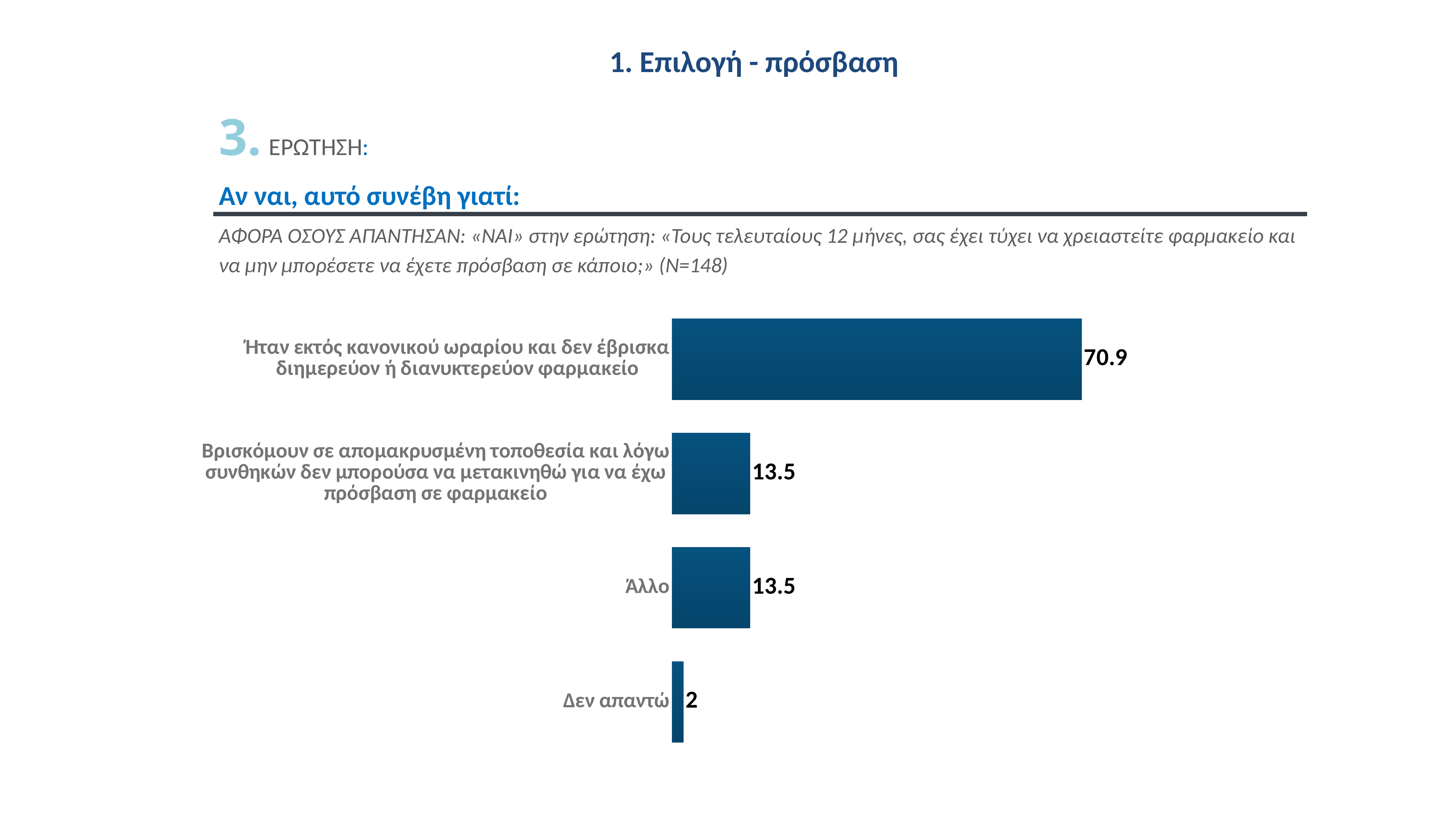
What is the value for 'Ήταν εκτός κανονικού ωραρίου και δεν έβρισκα διημερεύον ή διανυκτερεύον φαρμακείο'? 70.9 How many categories are shown in the chart? 4 Which is larger: the value for 'Άλλο' or the value for 'Δεν απαντώ'? Άλλο What is the value for 'Άλλο'? 13.5 What is the value for 'Δεν απαντώ'? 2 Which category has the highest value? Ήταν εκτός κανονικού ωραρίου και δεν έβρισκα διημερεύον ή διανυκτερεύον φαρμακείο What is the value for 'Βρισκόμουν σε απομακρυσμένη τοποθεσία και λόγω συνθηκών δεν μπορούσα να μετακινηθώ για να έχω πρόσβαση σε φαρμακείο'? 13.5 What is the difference between the value for 'Ήταν εκτός κανονικού ωραρίου και δεν έβρισκα διημερεύον ή διανυκτερεύον φαρμακείο' and the value for 'Άλλο'? 57.4 What is the sample size (N) stated in the note above the chart? N=148 Which category has the lowest value? Δεν απαντώ What is the difference between the value for 'Άλλο' and the value for 'Δεν απαντώ'? 11.5 What kind of chart is shown on the slide? Bar chart